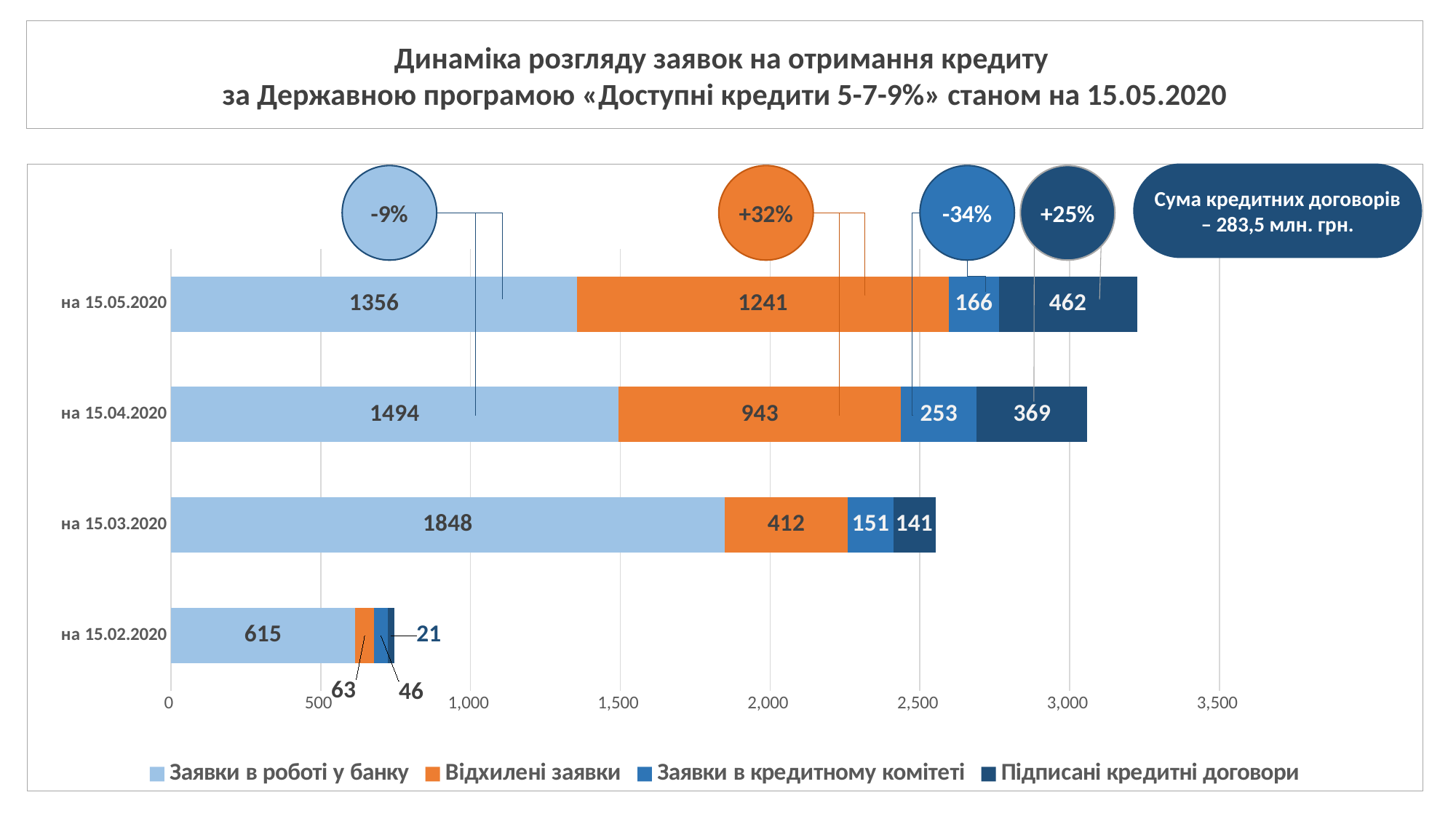
What is the difference between «Відхилені заявки» for на 15.05.2020 and на 15.04.2020? 298 What is the total of the stacked bar for на 15.05.2020? 3225 How many series does the legend list? 4 What is the value of «Заявки в роботі у банку» for на 15.05.2020? 1356 What is the value of «Відхилені заявки» for на 15.04.2020? 943 Which is larger: «Заявки в кредитному комітеті» for на 15.04.2020 or for на 15.05.2020? на 15.04.2020 On which date is the value of «Заявки в роботі у банку» highest? на 15.03.2020 What is the value of «Підписані кредитні договори» for на 15.03.2020? 141 How many dates (categories) are shown on the chart? 4 What kind of chart is shown on the slide? stacked bar chart On which date is the value of «Підписані кредитні договори» lowest? на 15.02.2020 What is the value of «Заявки в кредитному комітеті» for на 15.02.2020? 46